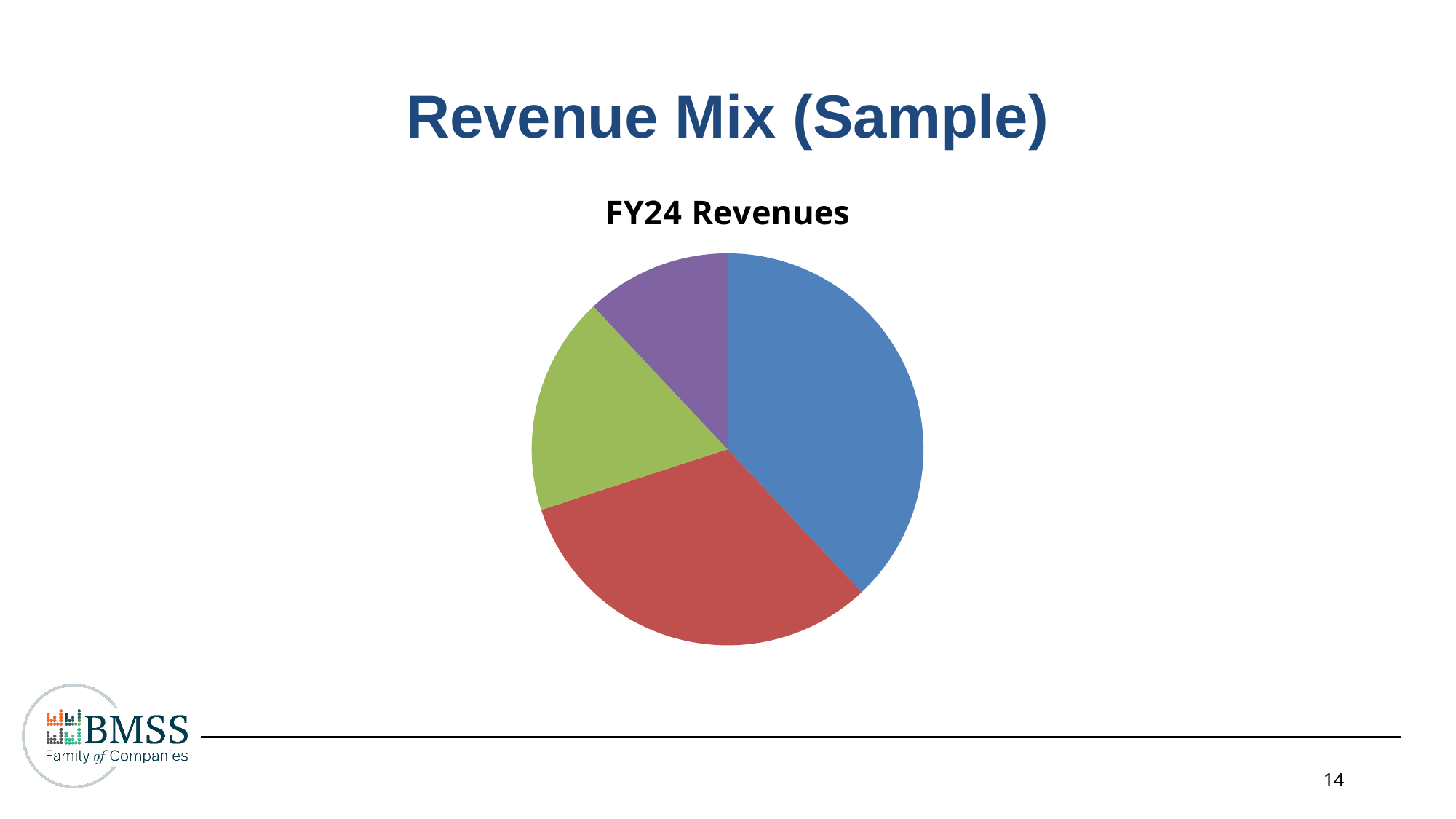
What kind of chart is shown on the slide? pie chart Which slice is larger, the blue slice or the red slice? blue What is the title of the chart? FY24 Revenues Does the chart display a legend? No How many slices does the pie chart have? 4 Which slice is larger, the green slice or the purple slice? green Which slice is larger, the red slice or the green slice? red Which colour slice is the smallest in the pie chart? purple Which colour slice is the largest in the pie chart? blue